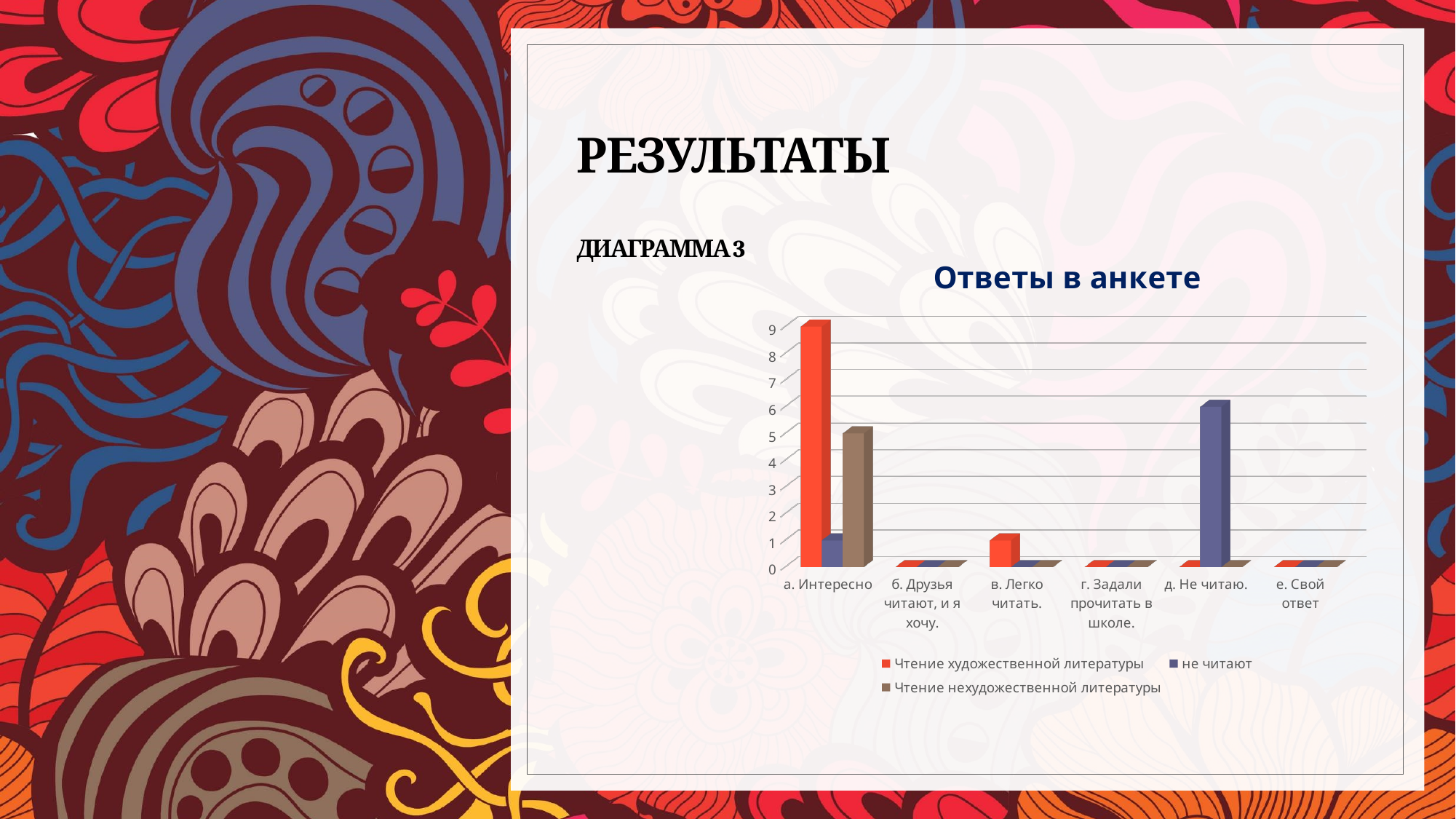
What kind of chart is shown on the slide? bar chart At "а. Интересно", which series has the larger value: "Чтение художественной литературы" or "не читают"? Чтение художественной литературы How many categories are shown on the x axis? 6 Is the value for "Чтение художественной литературы" at "в. Легко читать." greater or less than 2? less How many series does the legend list? 3 Is the value for "не читают" at "д. Не читаю." greater or less than 5? greater Is the value for "Чтение художественной литературы" at "а. Интересно" greater or less than 8? greater Which category has the highest value for the series "Чтение художественной литературы"? а. Интересно Which series is shown in red in the legend? Чтение художественной литературы Which category has the highest value for the series "не читают"? д. Не читаю. What is the title of the chart? Ответы в анкете